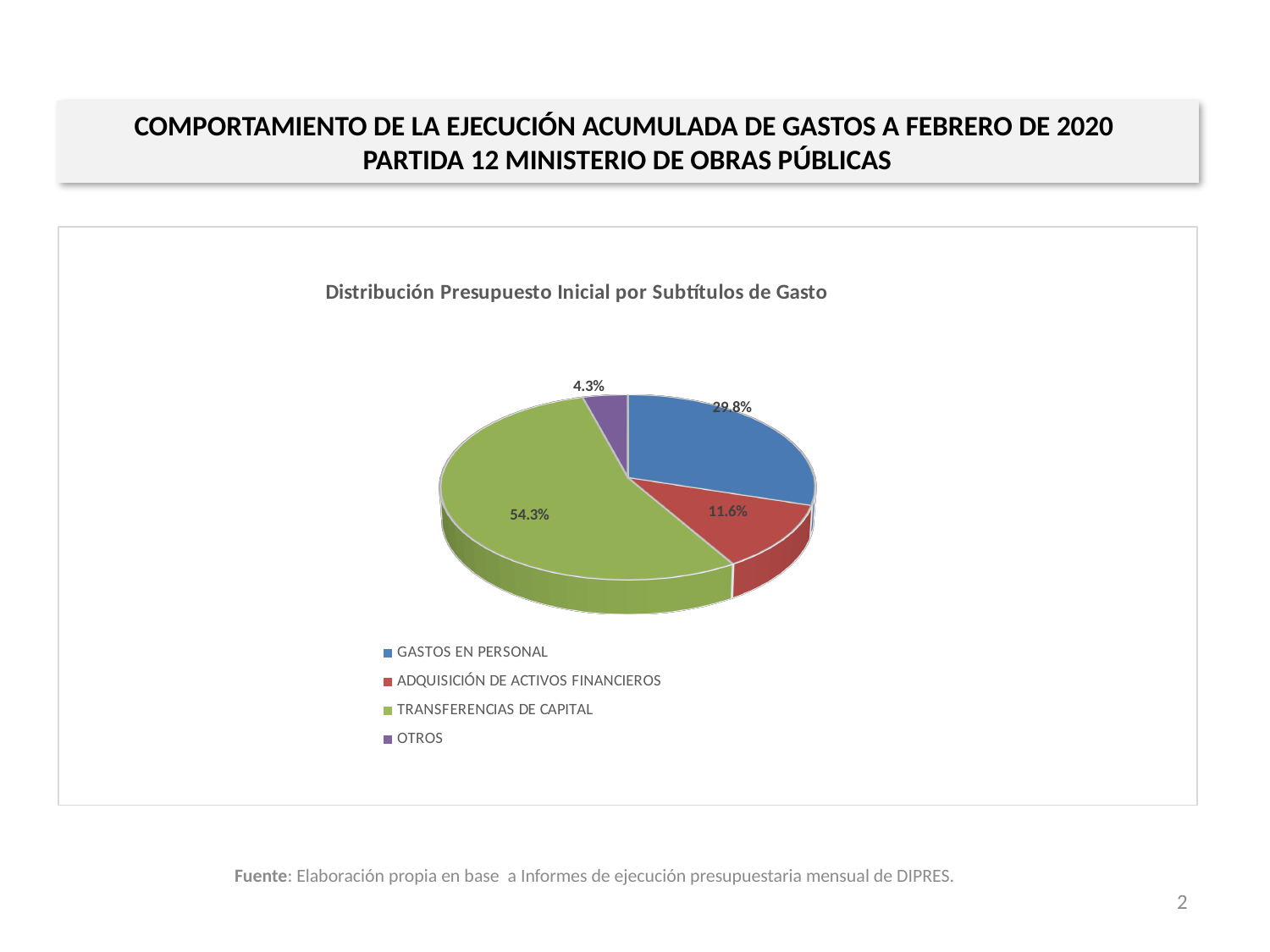
What share of the pie does GASTOS EN PERSONAL represent? 29.8% Which category has the largest slice of the pie? TRANSFERENCIAS DE CAPITAL What share of the pie does OTROS represent? 4.3% Which category has the smallest slice of the pie? OTROS What share of the pie does TRANSFERENCIAS DE CAPITAL represent? 54.3% How many categories does the legend list? 4 What is the difference in percentage points between TRANSFERENCIAS DE CAPITAL and GASTOS EN PERSONAL? 24.5 What type of chart is shown on the slide? Pie chart What colour is the slice for TRANSFERENCIAS DE CAPITAL? Green What is the title of the chart? Distribución Presupuesto Inicial por Subtítulos de Gasto Which is larger, the share for GASTOS EN PERSONAL or the share for ADQUISICIÓN DE ACTIVOS FINANCIEROS? GASTOS EN PERSONAL